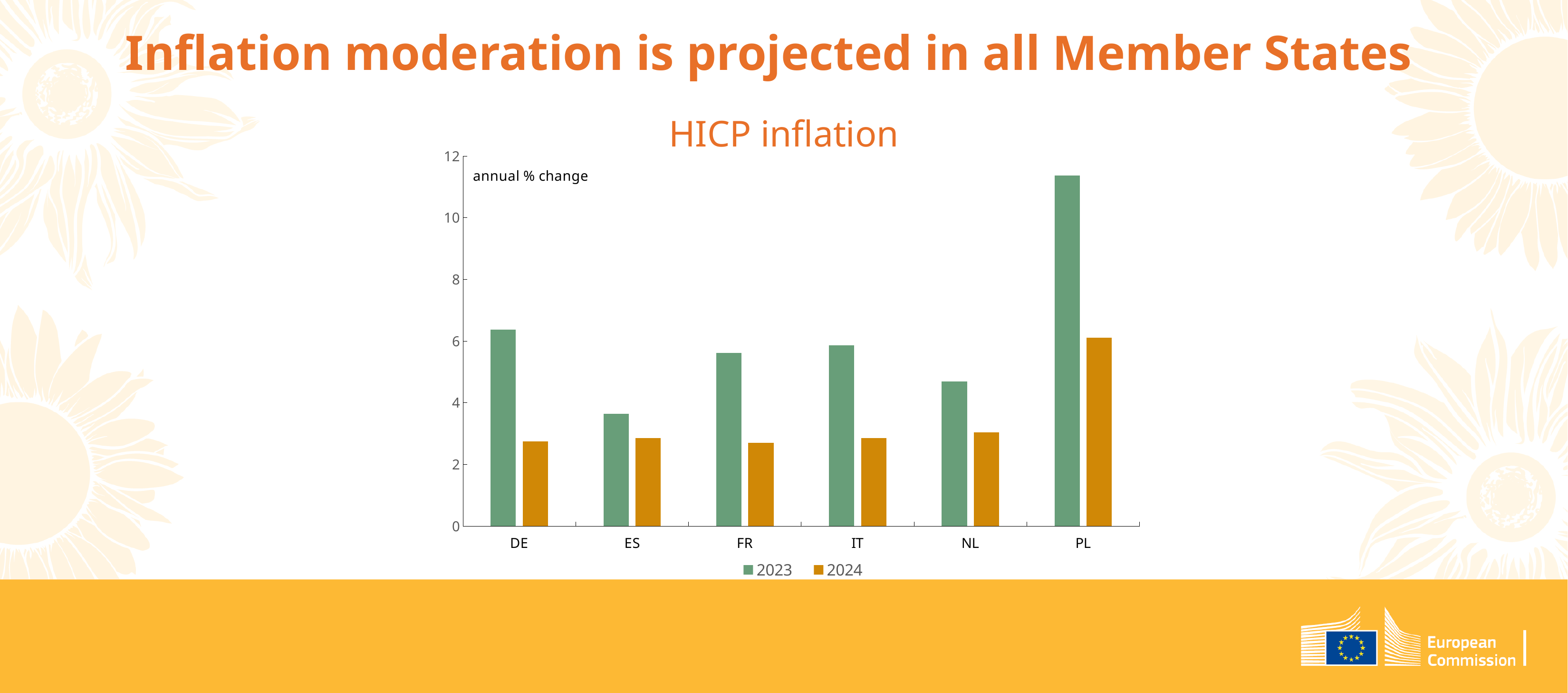
How many series does the legend of the HICP inflation chart list? 2 Is the 2023 value for PL greater or less than 10? greater Which country has the highest 2023 HICP inflation value? PL Which country has the lowest 2023 HICP inflation value? ES Which country has the highest 2024 HICP inflation value? PL What kind of chart is shown on the slide? bar chart Is the 2023 value for ES greater or less than 4? less For every country, is the 2024 value higher or lower than the 2023 value? lower How many countries are shown on the x axis of the HICP inflation chart? 6 Which is larger, the 2023 value for DE or the 2023 value for FR? DE Is the 2024 value for NL greater or less than 4? less What unit is stated in the top-left corner of the chart's plot area? annual % change